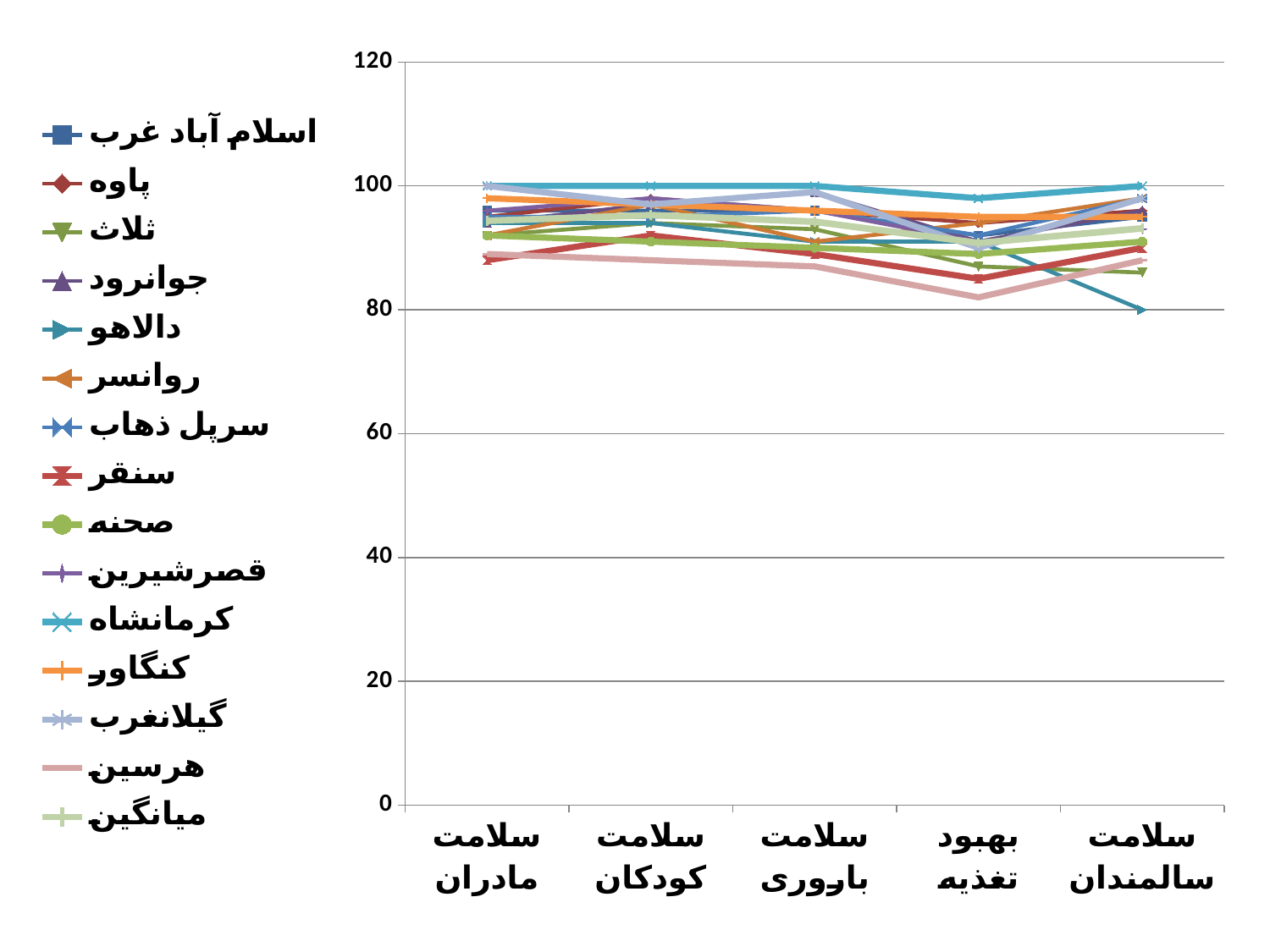
What is the value for کرمانشاه at سلامت مادران? 100 What kind of chart is shown on the slide? line chart How many categories are shown on the x axis? 5 Which series has the lowest value at سلامت سالمندان? دالاهو Is the value for هرسین at بهبود تغذیه greater or less than 60? greater How many series does the legend list? 15 Which legend entry is listed last? میانگین Which series has the lowest value at بهبود تغذیه? هرسین Which series has the highest value at سلامت سالمندان? کرمانشاه Does the line for دالاهو rise or fall from سلامت مادران to سلامت سالمندان? fall At سلامت سالمندان, which is larger: کرمانشاه or دالاهو? کرمانشاه What is the value for دالاهو at سلامت سالمندان? 80